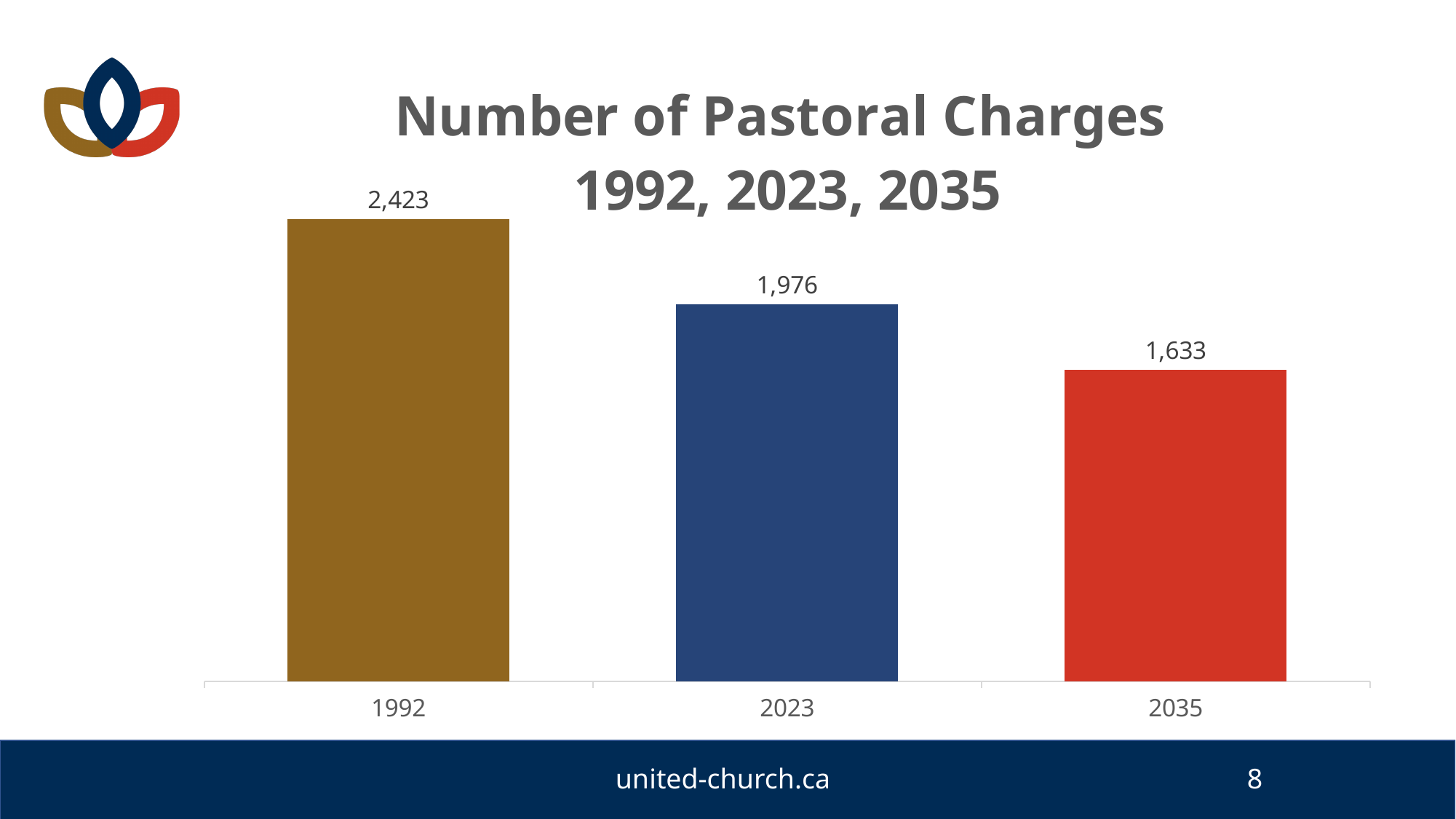
What is the difference between the number of pastoral charges in 1992 and in 2035? 790 What is the number of pastoral charges shown for 2035? 1,633 What is the number of pastoral charges shown for 2023? 1,976 What is the difference between the number of pastoral charges in 1992 and in 2023? 447 What is the number of pastoral charges shown for 1992? 2,423 What is the difference between the number of pastoral charges in 2023 and in 2035? 343 What kind of chart is shown on the slide? Bar chart Which year has the highest number of pastoral charges? 1992 Which year has the lowest number of pastoral charges? 2035 How many years are shown on the chart? 3 Do the values rise or fall from 1992 to 2035? Fall Which is larger, the number of pastoral charges in 2023 or in 2035? 2023